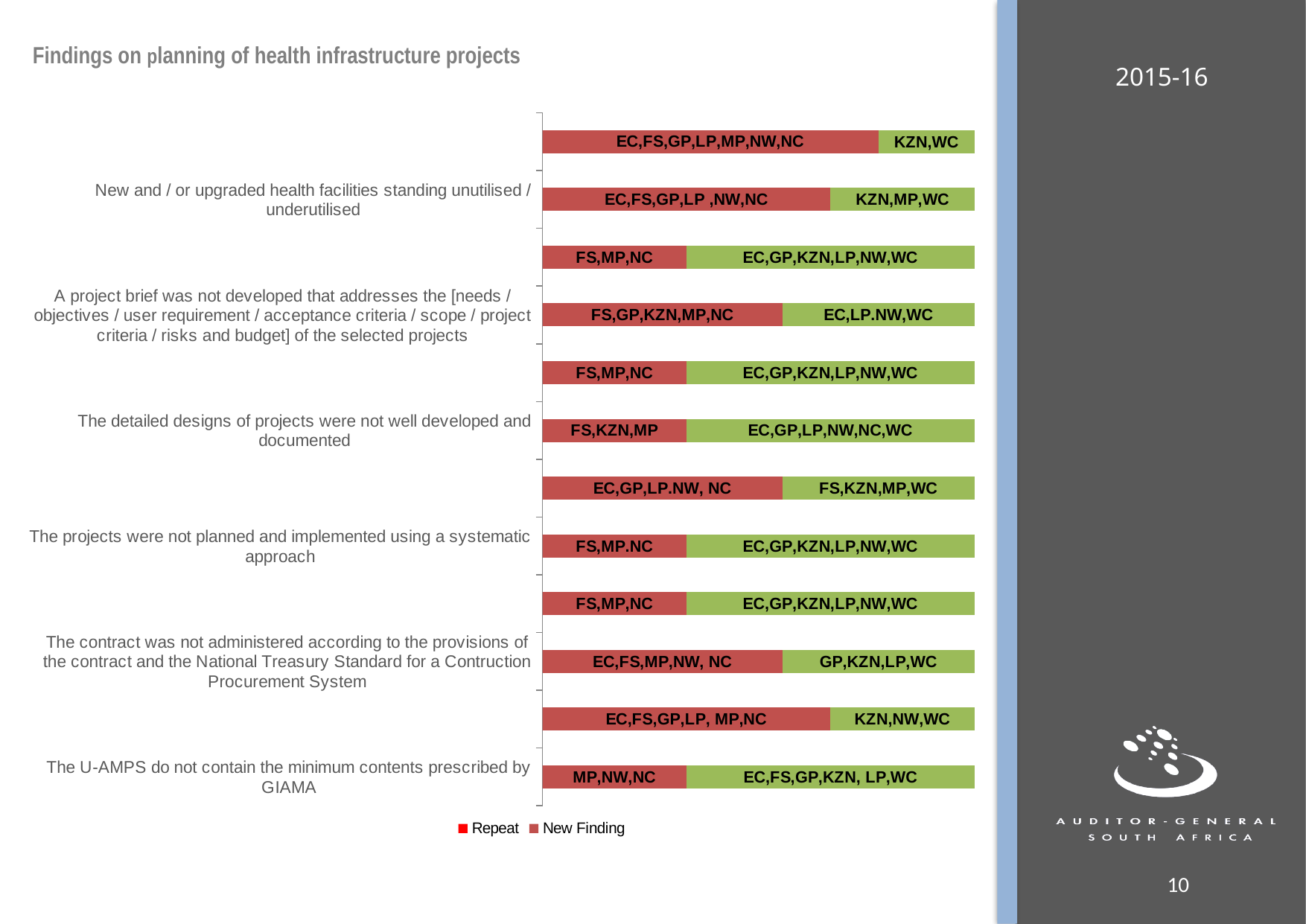
What are the two series named in the legend? Repeat and New Finding Which provinces are listed in the red segment of the bar for 'The detailed designs of projects were not well developed and documented'? FS,KZN,MP Which provinces are listed in the green segment of the bar for 'The U-AMPS do not contain the minimum contents prescribed by GIAMA'? EC,FS,GP,KZN, LP,WC Which provinces are listed in the green segment of the bar for 'The contract was not administered according to the provisions of the contract and the National Treasury Standard for a Contruction Procurement System'? GP,KZN,LP,WC Which provinces are listed in the red segment of the bar for 'New and / or upgraded health facilities standing unutilised / underutilised'? EC,FS,GP,LP ,NW,NC Which provinces are listed in the green segment of the bar for 'New and / or upgraded health facilities standing unutilised / underutilised'? KZN,MP,WC How many bars are plotted in the chart? 12 What kind of chart is shown on the slide? Stacked bar chart Which provinces are listed in the red segment of the bar for 'The U-AMPS do not contain the minimum contents prescribed by GIAMA'? MP,NW,NC For the bar 'The detailed designs of projects were not well developed and documented', is the red segment or the green segment longer? Green How many series does the legend list? 2 For the bar 'New and / or upgraded health facilities standing unutilised / underutilised', is the red segment or the green segment longer? Red